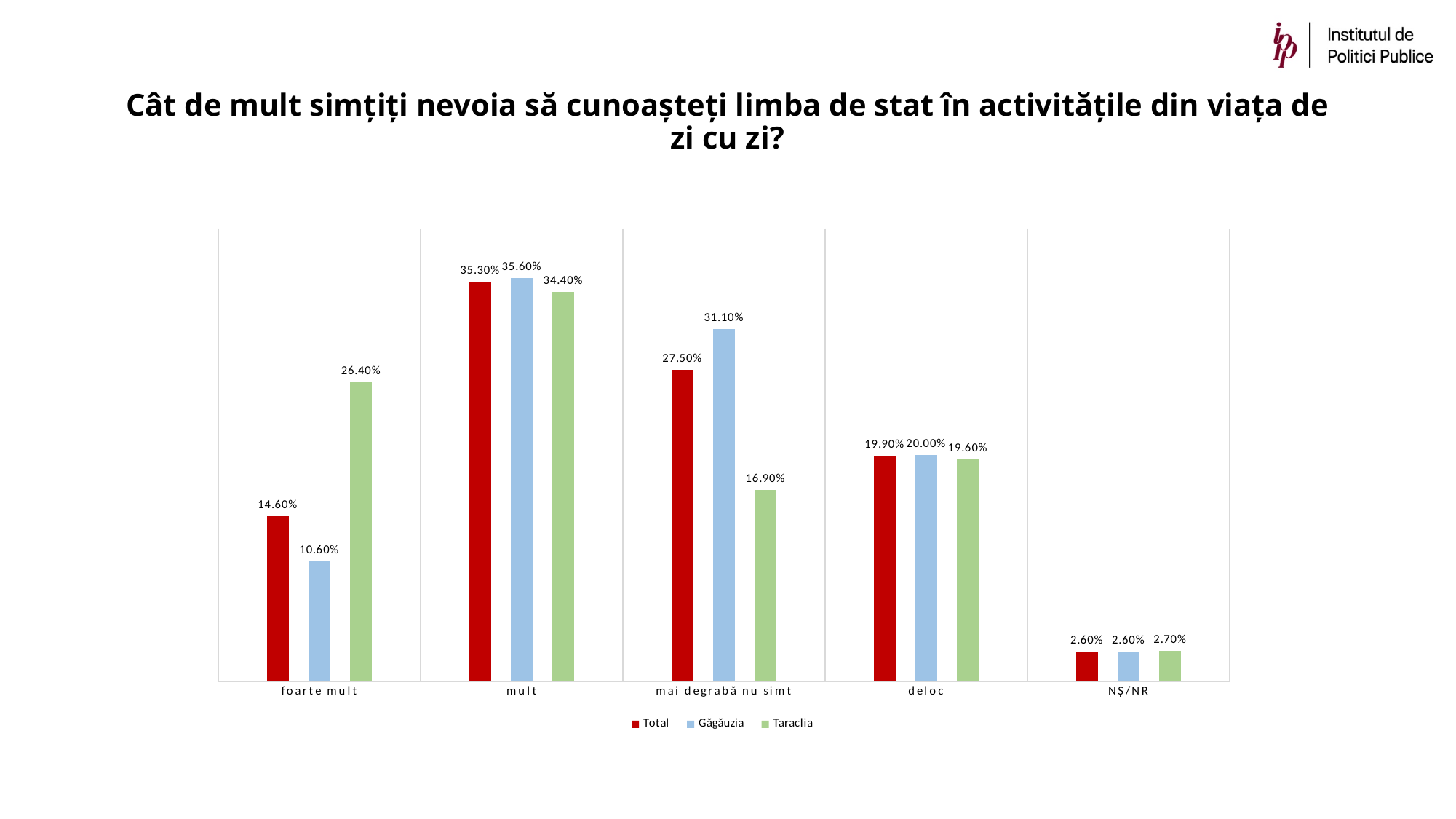
Which category has the lowest Găgăuzia value? NȘ/NR Which series is shown in red in the legend? Total For "foarte mult", which is larger: the Total value or the Găgăuzia value? Total How many categories are shown on the x axis? 5 How many series does the legend list? 3 What is the Total value for "deloc"? 19.90% Which category has the highest Total value? mult What is the difference between the Taraclia and Total values for "foarte mult"? 11.80% What is the difference between the Găgăuzia and Taraclia values for "mai degrabă nu simt"? 14.20% What is the Găgăuzia value for "mai degrabă nu simt"? 31.10% What is the Taraclia value for "foarte mult"? 26.40% What kind of chart is shown on the slide? bar chart